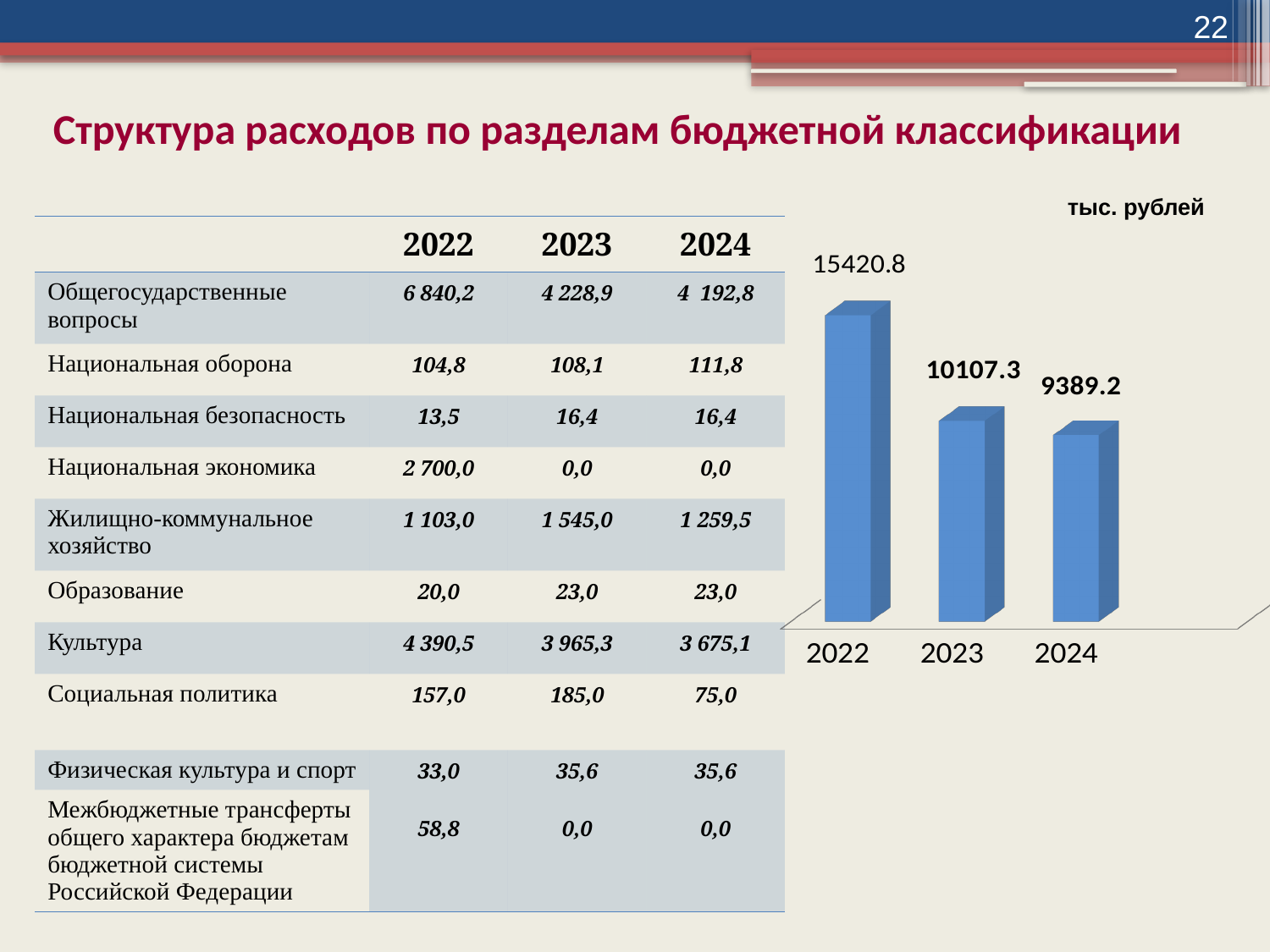
What is the value shown for 2023 on the bar chart? 10107.3 What type of chart is shown on the right side of the slide? bar chart How many bars are shown on the bar chart? 3 Which year has the highest value on the bar chart? 2022 What is the value shown for 2024 on the bar chart? 9389.2 Which year has the lowest value on the bar chart? 2024 What is the difference between the 2022 and 2023 values on the bar chart? 5313.5 What unit is indicated above the bar chart? тыс. рублей What is the difference between the 2023 and 2024 values on the bar chart? 718.1 On the bar chart, which is larger: the value for 2023 or the value for 2024? 2023 Do the values on the bar chart rise or fall from 2022 to 2024? fall What is the value shown for 2022 on the bar chart? 15420.8